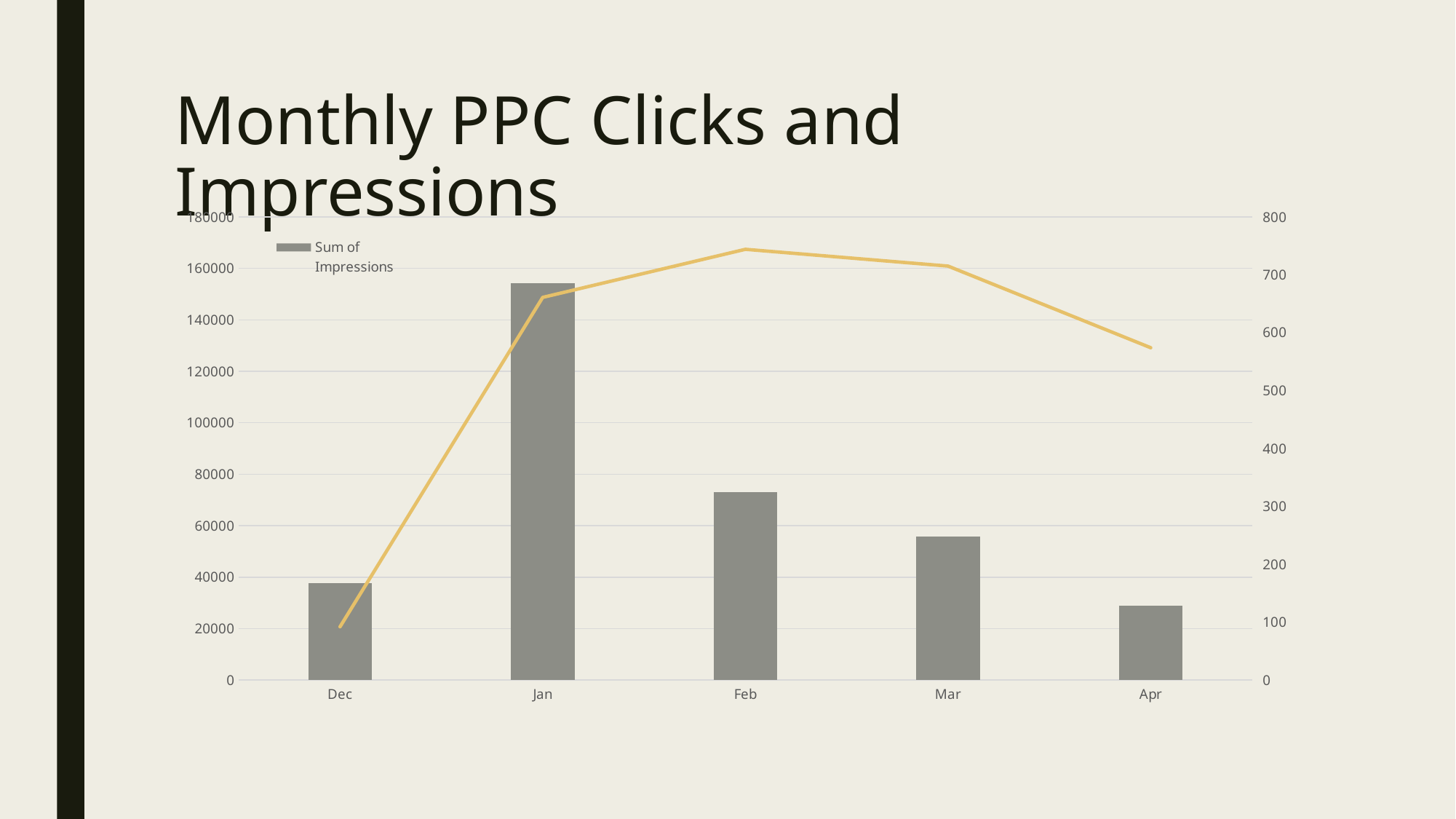
Which month has the lowest Sum of Impressions? Apr How many series does the legend list? 1 On the right-hand axis, is the line value for Feb greater or less than 700? greater How many months are shown on the x axis? 5 Is the Sum of Impressions for Mar greater or less than 60000? less Which month has a larger Sum of Impressions, Feb or Mar? Feb Is the Sum of Impressions for Dec greater or less than 20000? greater What kind of chart is shown on the slide? A bar chart with a line overlaid Do the Sum of Impressions bars rise or fall from Jan to Apr? fall Which month has the highest Sum of Impressions? Jan